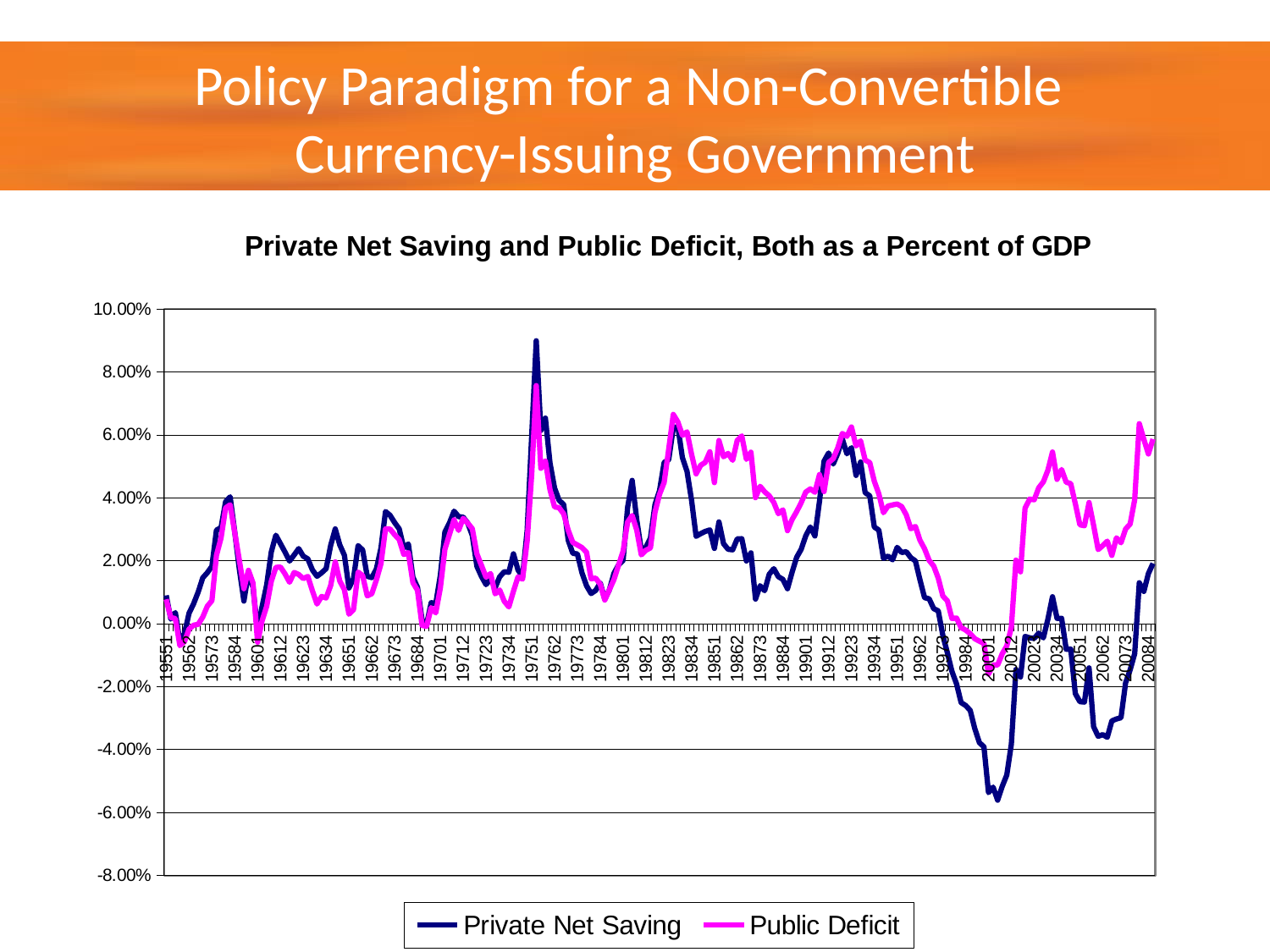
Between 20062 and 20084, does the Public Deficit line rise or fall? rise Around 20034, which series has the higher value, Private Net Saving or Public Deficit? Public Deficit Which colour is used for the Public Deficit line? magenta Is the lowest value of Private Net Saving, around 20001, greater or less than -4.00%? less Is the value of Public Deficit around 20034 greater or less than 4.00%? greater Which series reaches the lowest value on the chart? Private Net Saving What kind of chart is shown on the slide? line chart What is the title of the chart? Private Net Saving and Public Deficit, Both as a Percent of GDP Which series reaches the highest value on the chart? Private Net Saving How many series does the legend list? 2 Is the peak value of Private Net Saving around 19751 greater or less than 8.00%? greater